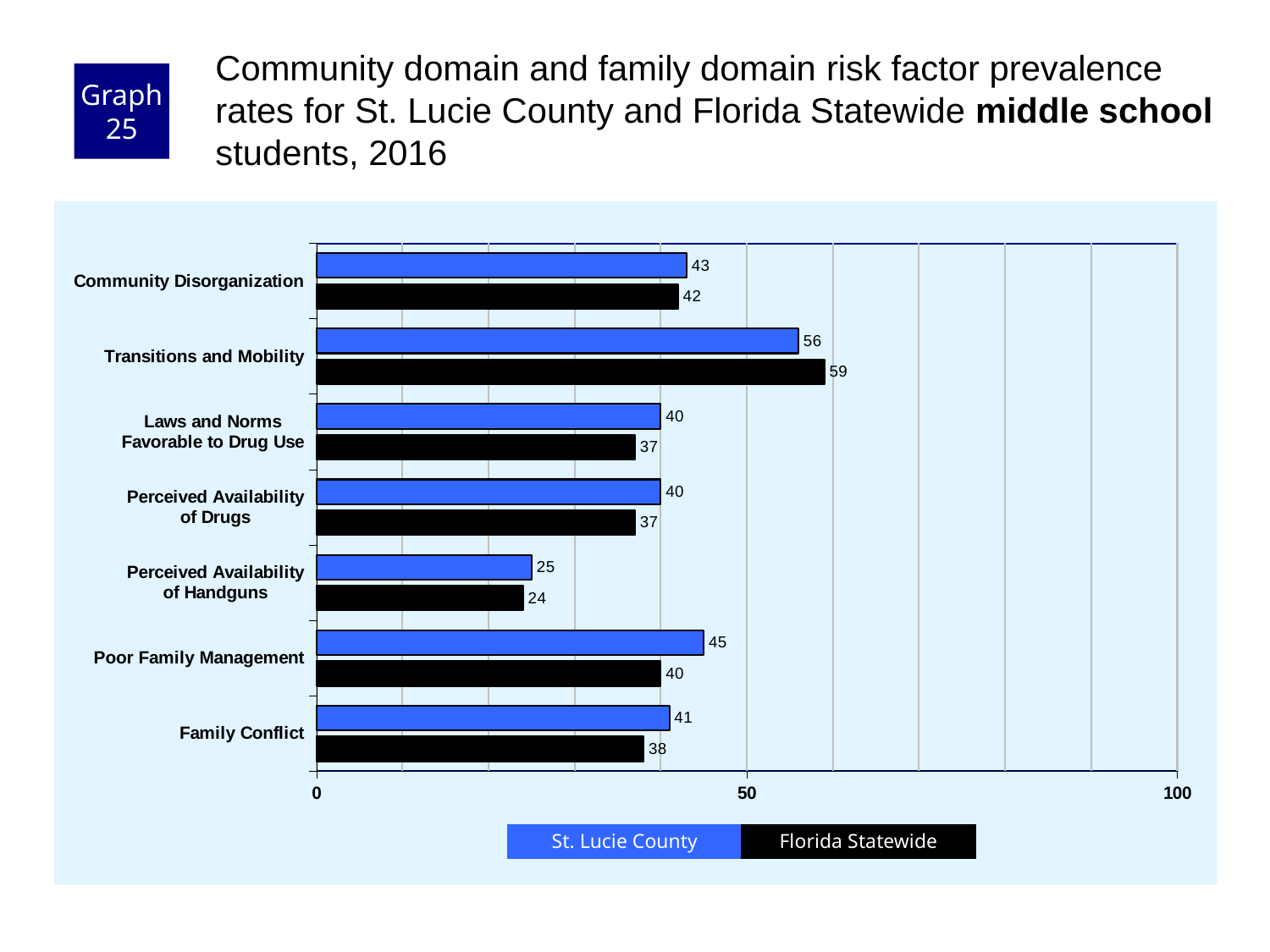
What is the Florida Statewide value for Perceived Availability of Handguns? 24 How many risk factors are shown on the chart? 7 What kind of chart is shown on the slide? bar chart What is the St. Lucie County value for Transitions and Mobility? 56 Is the St. Lucie County value for Transitions and Mobility greater or less than 50? greater For Transitions and Mobility, which is larger: the St. Lucie County value or the Florida Statewide value? Florida Statewide What is the difference between the St. Lucie County and Florida Statewide values for Poor Family Management? 5 Which risk factor has the lowest St. Lucie County value? Perceived Availability of Handguns Which risk factor has the highest Florida Statewide value? Transitions and Mobility What is the Florida Statewide value for Family Conflict? 38 How many series does the legend list? 2 Which colour represents Florida Statewide in the chart? black